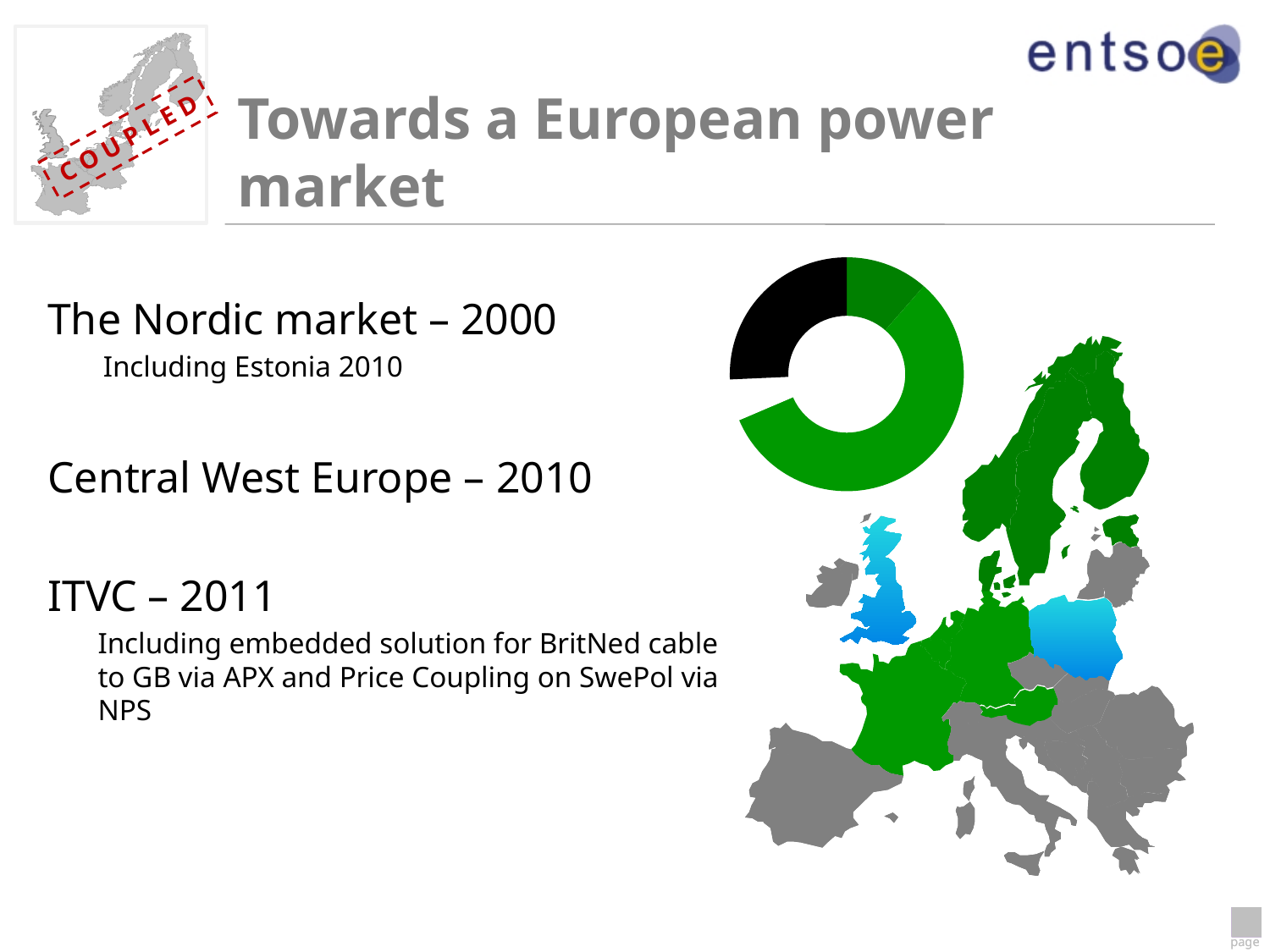
In the doughnut chart, which is larger: the black slice or the dark green slice? The black slice In the doughnut chart, which is larger: the bright green slice or the black slice? The bright green slice How many slices does the doughnut chart contain? 4 Which colour slice is the smallest in the doughnut chart? White Which colour slice is the largest in the doughnut chart? Bright green Does the doughnut chart show any data labels or values on its slices? No Does the doughnut chart display a legend? No What kind of chart is shown on the right side of the slide, above the map? Doughnut chart